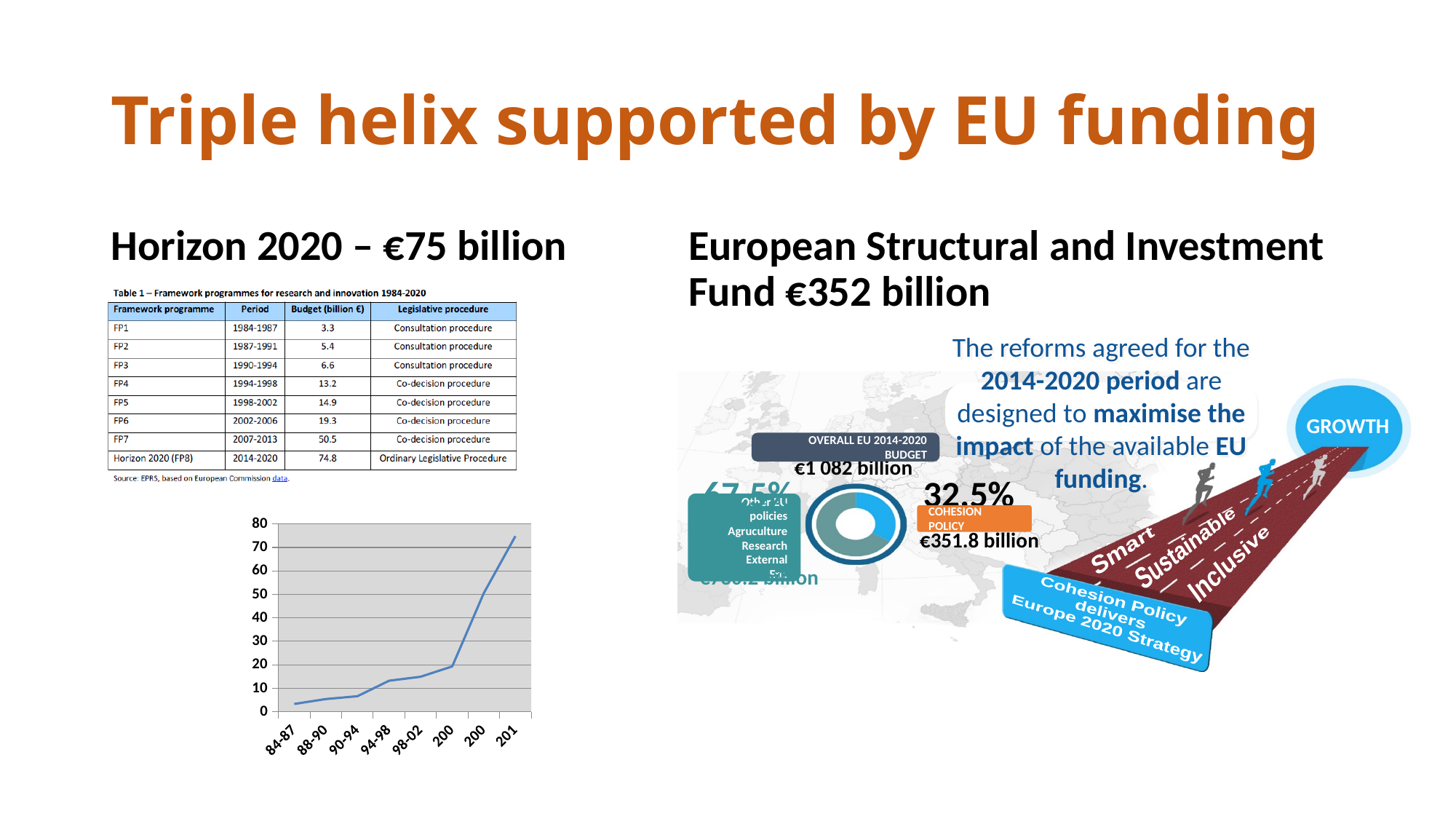
In the donut chart on the right side of the slide, what share of the overall EU 2014-2020 budget goes to Cohesion Policy? 32.5% In the line chart at the bottom left, which x-axis category has the lowest value? 84-87 In the line chart at the bottom left, how many data points are plotted? 8 In the line chart at the bottom left, what is the highest value shown on the y axis? 80 In the line chart at the bottom left, do the values generally rise or fall from left to right along the x axis? rise In the line chart at the bottom left, which is larger: the value for 94-98 or the value for 88-90? 94-98 In the line chart at the bottom left, is the value for the last point (201) greater or less than 70? greater What kind of chart is shown at the bottom left of the slide? line chart In the line chart at the bottom left, is the value for 84-87 greater or less than 10? less In the donut chart on the right side of the slide, what amount is shown for Cohesion Policy? €351.8 billion In the line chart at the bottom left, which x-axis category has the highest value? 201 In the line chart at the bottom left, is the value for 98-02 greater or less than 20? less